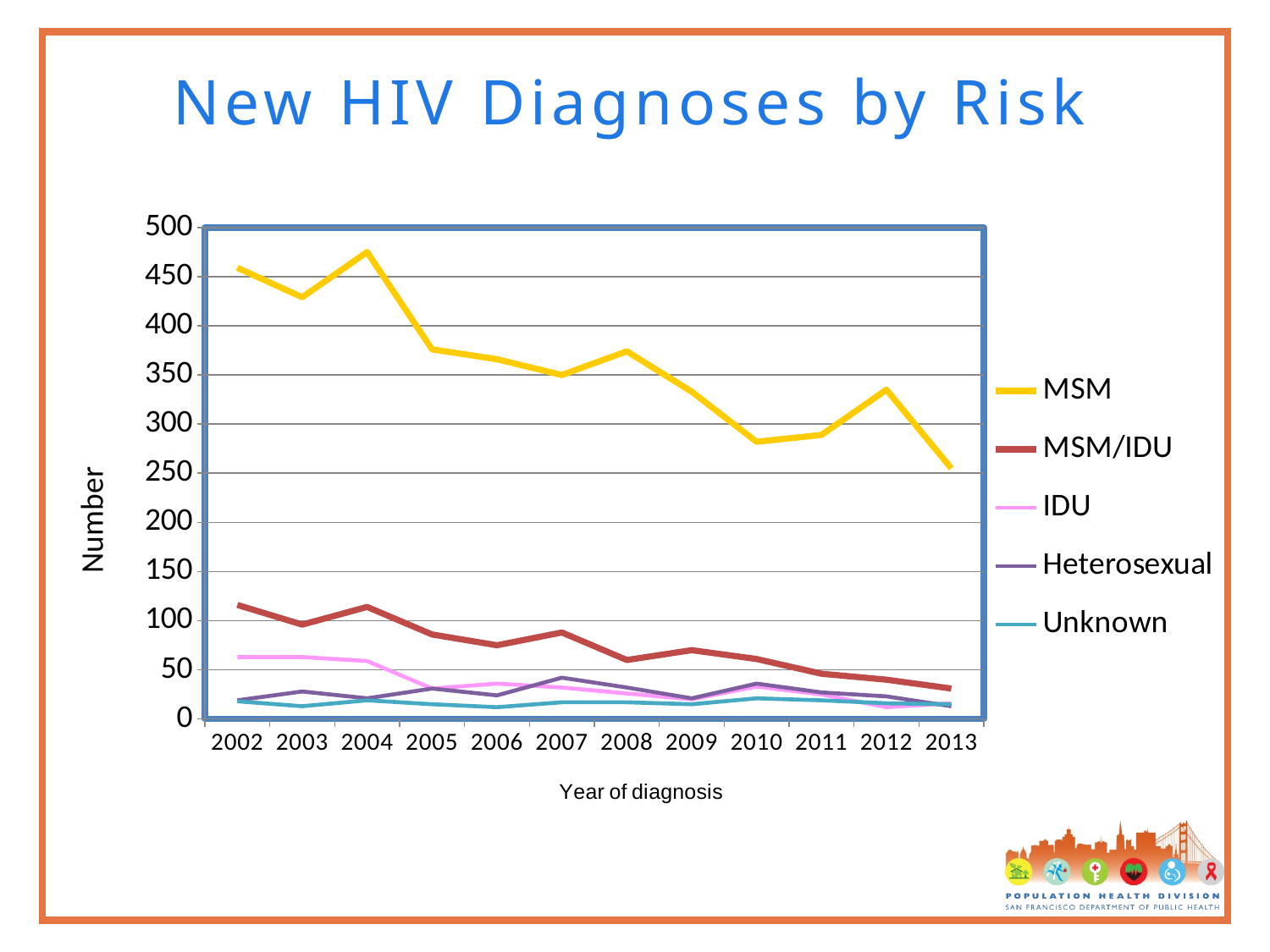
What is the title of the chart? New HIV Diagnoses by Risk Is the MSM value for 2013 greater or less than 300? less Is the MSM/IDU value for 2002 greater or less than 100? greater Does the MSM line rise or fall overall from 2002 to 2013? fall What kind of chart is shown on the slide? line chart Is the MSM value for 2004 greater or less than 450? greater Which series has the highest values across all years? MSM How many years are plotted along the x axis? 12 How many series does the legend list? 5 What is the label of the x axis? Year of diagnosis In which year does the MSM line reach its highest value? 2004 In 2002, which is larger, the MSM/IDU value or the IDU value? MSM/IDU